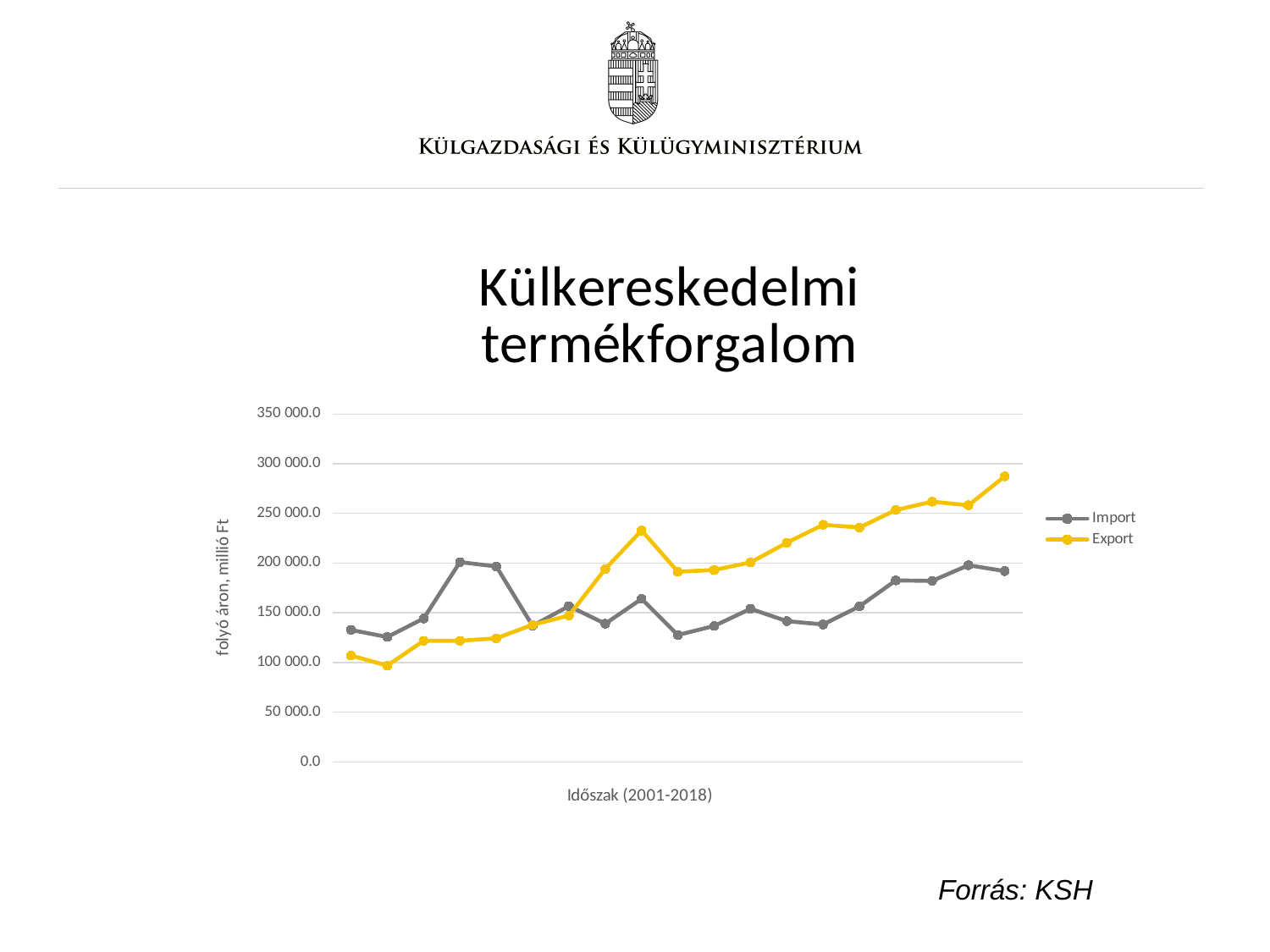
How many series does the legend list? 2 What kind of chart is shown on the slide? line chart Which series has the higher value at the first point on the x axis? Import What are the names of the two series in the legend? Import and Export Which series has the higher value at the last point on the x axis? Export Is the value of the Import series at the first point greater or less than 100 000.0? greater Is the value of the Export series at the last point greater or less than 250 000.0? greater Does the Export series overall rise or fall along the x axis? rise What is the title of the chart? Külkereskedelmi termékforgalom How many data points does each series have? 19 Is the value of the Import series at the last point greater or less than 250 000.0? less At which point along the x axis does the Export series reach its highest value? the last point